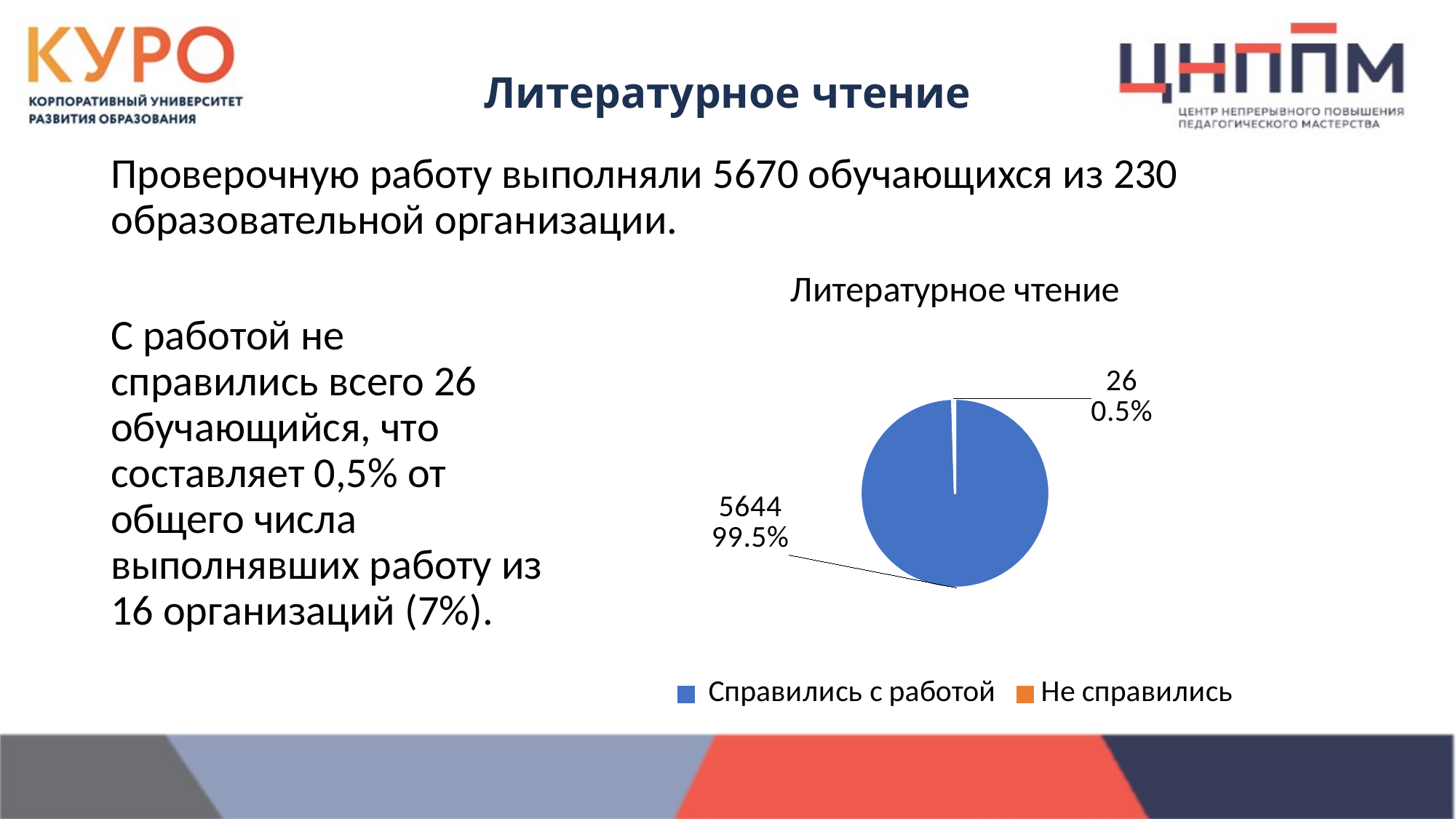
How many entries does the chart legend list? 2 Which category has the smallest slice? Не справились What is the title of the chart? Литературное чтение How many slices does the pie chart have? 2 What colour is the "Не справились" slice according to the legend? orange What kind of chart is shown on the slide? pie chart What is the value for "Справились с работой"? 5644 What is the difference between the values for "Справились с работой" and "Не справились"? 5618 What share of the pie does "Не справились" represent? 0.5% What is the value for "Не справились"? 26 Which category has the largest slice? Справились с работой What share of the pie does "Справились с работой" represent? 99.5%